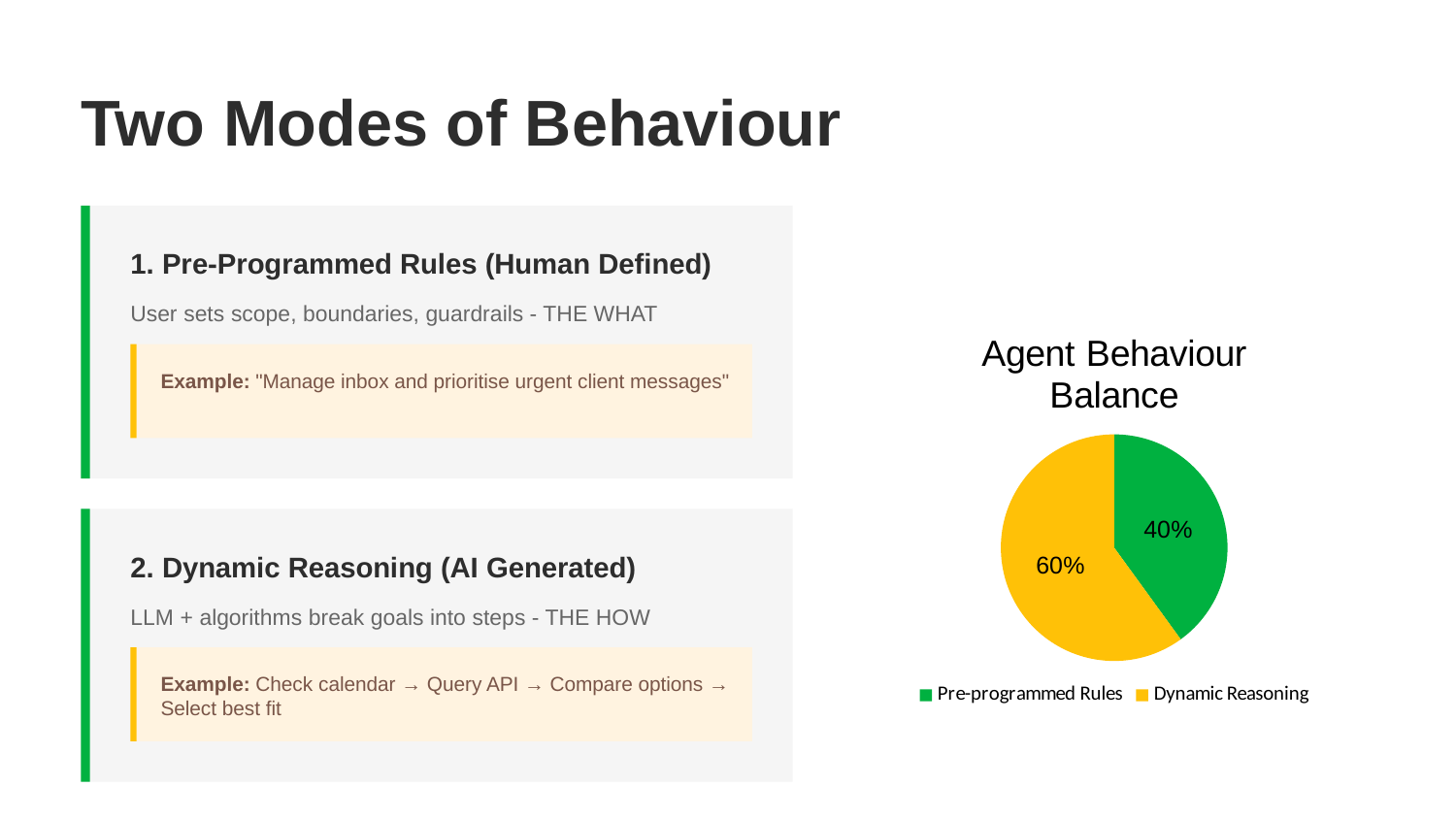
Which slice of the pie is the smallest? Pre-programmed Rules Which slice of the pie is the largest? Dynamic Reasoning What is the title of the chart? Agent Behaviour Balance What kind of chart is shown on the slide? pie chart What share of the pie does Dynamic Reasoning take? 60% How many slices does the pie chart have? 2 What is the difference between the Dynamic Reasoning share and the Pre-programmed Rules share? 20% Which is larger, Pre-programmed Rules or Dynamic Reasoning? Dynamic Reasoning What colour is the Dynamic Reasoning slice? yellow What share of the pie does Pre-programmed Rules take? 40% How many entries does the legend list? 2